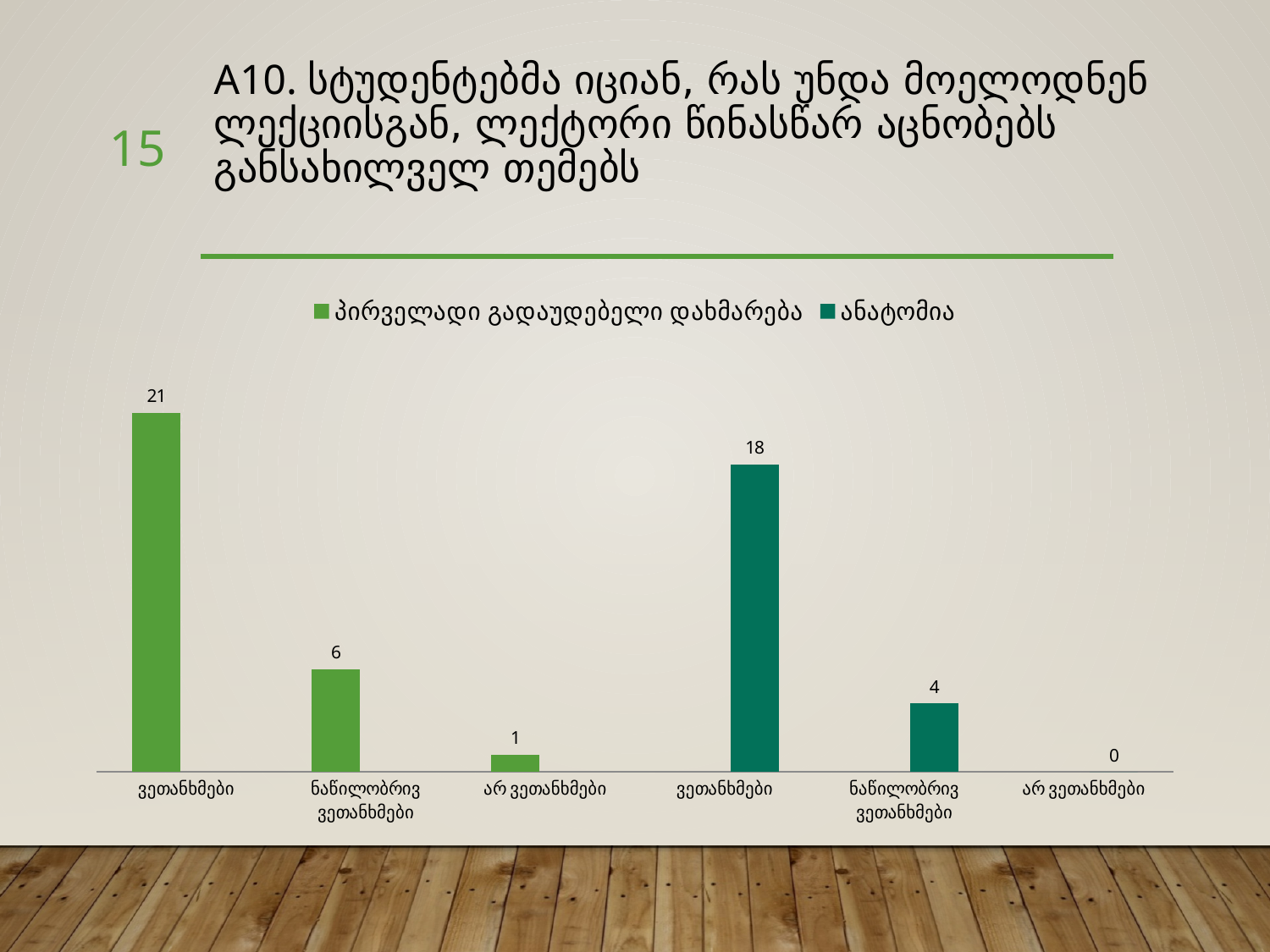
What is the value for ნაწილობრივ ვეთანხმები in the პირველადი გადაუდებელი დახმარება series? 6 What is the value for არ ვეთანხმები in the ანატომია series? 0 What type of chart is shown on the slide? bar chart What is the value for ვეთანხმები in the ანატომია series? 18 How many series does the legend list? 2 What is the value for ვეთანხმები in the პირველადი გადაუდებელი დახმარება series? 21 What is the difference between the ვეთანხმები values of the two series? 3 What colour are the bars of the ანატომია series? dark green Which is larger: ნაწილობრივ ვეთანხმები for პირველადი გადაუდებელი დახმარება or for ანატომია? პირველადი გადაუდებელი დახმარება How many bars are plotted on the chart? 6 Which bar has the lowest value on the chart? არ ვეთანხმები (ანატომია) Which bar has the highest value on the chart? ვეთანხმები (პირველადი გადაუდებელი დახმარება)